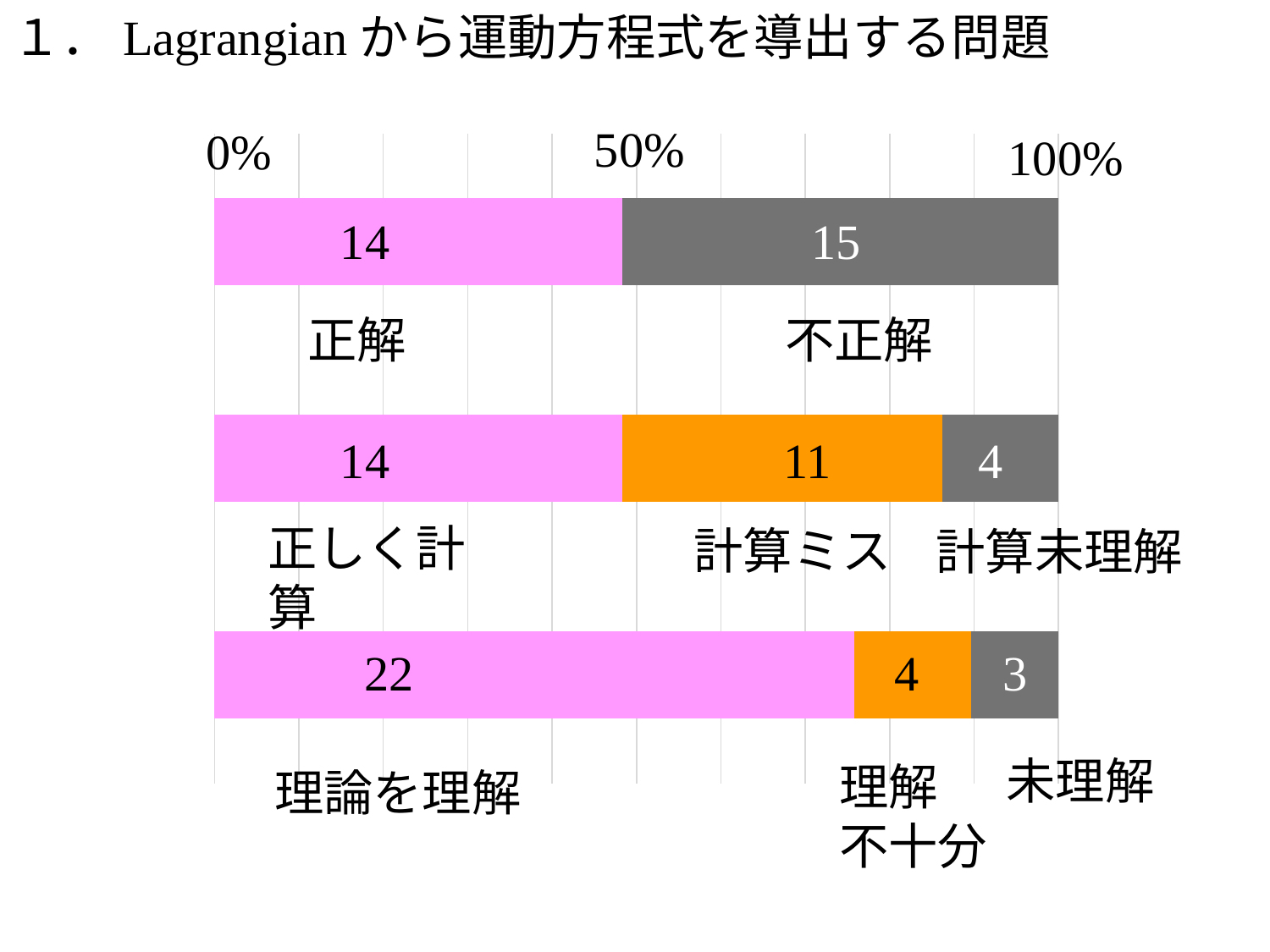
Which segment in the bottom bar has the smallest value? 未理解 How many stacked bars does the chart contain? 3 What kind of chart is shown on the slide? stacked bar chart In the top bar, what is the value labelled 不正解? 15 In the middle bar, what is the value for 計算未理解? 4 What is the total of the segments in the middle bar (正しく計算, 計算ミス, 計算未理解)? 29 What is the difference between 理論を理解 (22) and 理解不十分 (4) in the bottom bar? 18 In the bottom bar, what is the value for 未理解? 3 In the middle bar, what is the value for 計算ミス? 11 In the top bar, what is the value labelled 正解? 14 In the bottom bar, what is the value for 理論を理解? 22 Which is larger in the top bar, 正解 or 不正解? 不正解